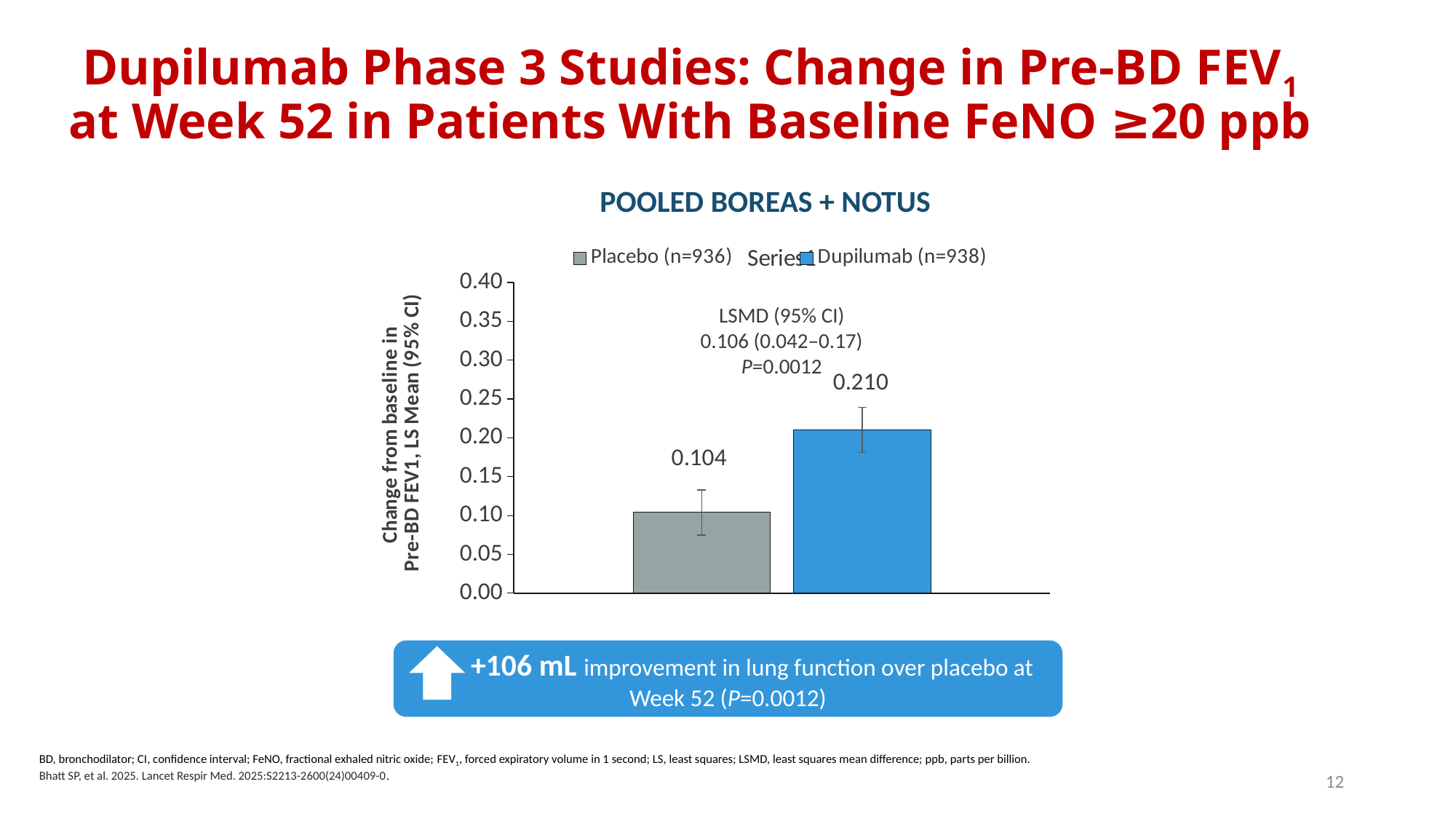
What is the title shown above the chart? POOLED BOREAS + NOTUS What is the change from baseline in pre-BD FEV1 for the Dupilumab (n=938) bar? 0.210 What is the change from baseline in pre-BD FEV1 for the Placebo (n=936) bar? 0.104 What is the difference between the Dupilumab and Placebo bar values? 0.106 What kind of chart is shown on the slide? Bar chart Is the value for Dupilumab (n=938) greater or less than 0.25? less Is the value for Dupilumab (n=938) greater or less than 0.15? greater Is the value for Placebo (n=936) greater or less than 0.15? less What LSMD (95% CI) is annotated on the chart? 0.106 (0.042–0.17) How many bars are plotted in the chart? 2 Which group has the higher change from baseline in pre-BD FEV1? Dupilumab (n=938) Which group has the lower change from baseline in pre-BD FEV1? Placebo (n=936)